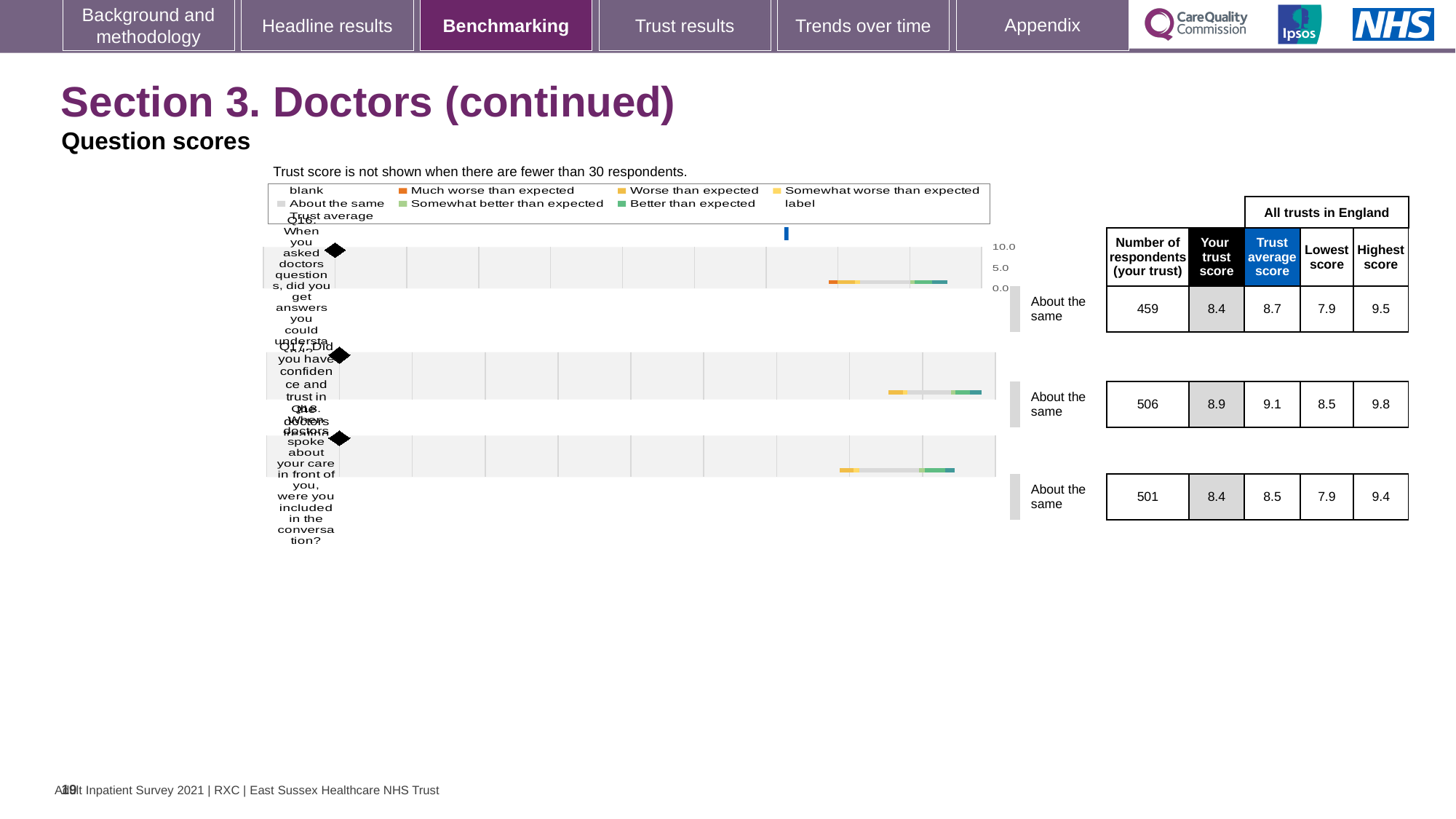
What kind of chart is used to show the question scores on this slide? bar chart For Q16, which is larger: your trust score or the trust average score? Trust average score What is the 'Your trust score' for Q17 (Did you have confidence and trust in the doctors treating you)? 8.9 How many questions (Q16, Q17, Q18) are plotted in the question scores chart? 3 What is the trust average score for all trusts in England for Q17? 9.1 Which question has the highest 'Your trust score'? Q17 What is the difference between the highest score (9.8) and the lowest score (8.5) for Q17? 1.3 What is the highest score across all trusts in England for Q16? 9.5 What benchmark category is shown for Q18 (When doctors spoke about your care in front of you, were you included in the conversation)? About the same Which question has the fewest respondents (your trust)? Q16 What is the number of respondents (your trust) for Q18? 501 What is the 'Your trust score' for Q16 (When you asked doctors questions, did you get answers you could understand)? 8.4